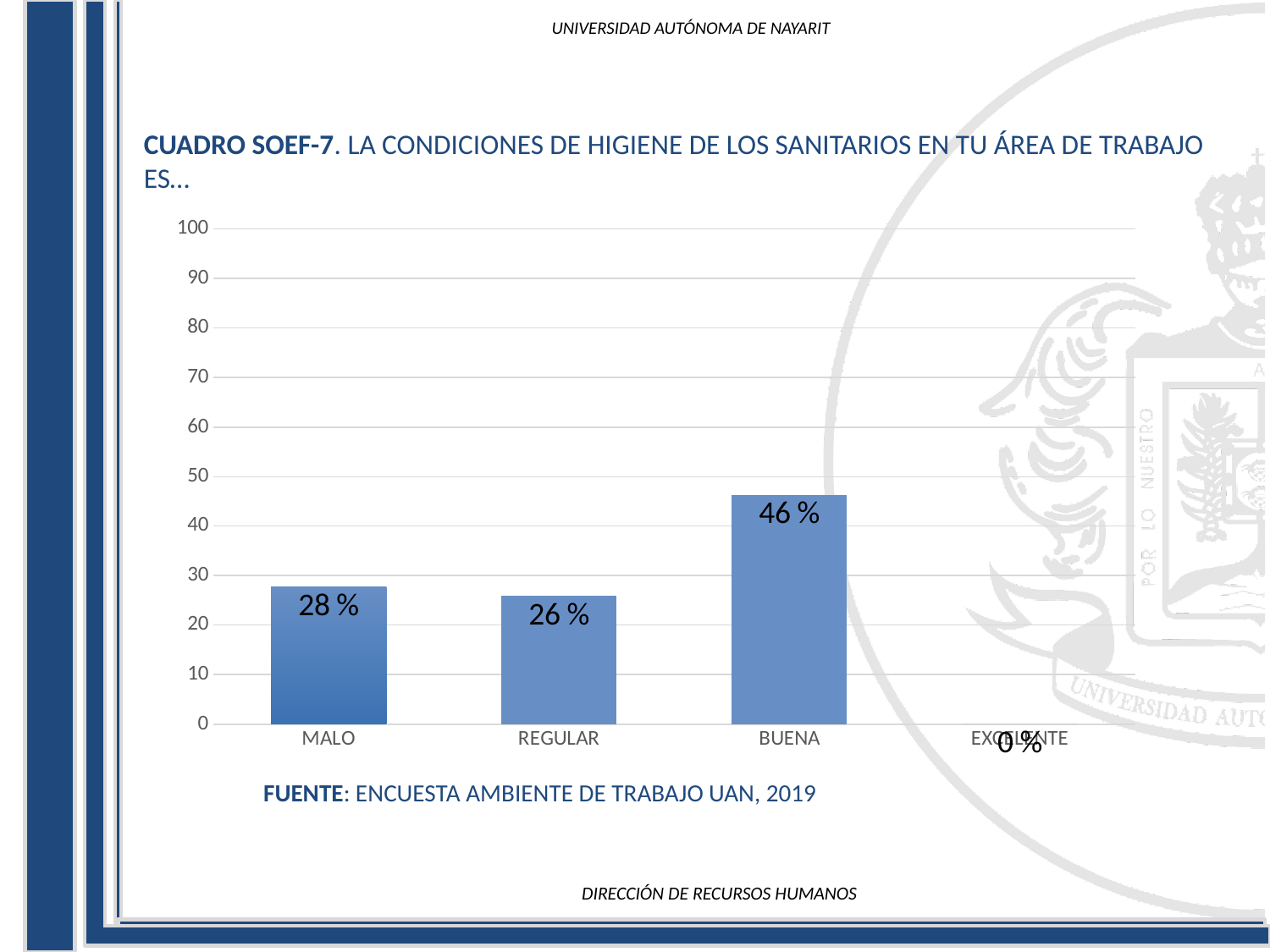
How many categories are shown on the x axis? 4 What is the value for REGULAR? 26 % What source is cited below the chart? ENCUESTA AMBIENTE DE TRABAJO UAN, 2019 What is the value for MALO? 28 % Which is larger, the value for MALO or the value for REGULAR? MALO Which category has the lowest value? EXCELENTE What kind of chart is shown on the slide? bar chart What is the value for BUENA? 46 % What is the value for EXCELENTE? 0 % What is the difference between the values for BUENA and MALO? 18 % Is the value for BUENA greater or less than 40? greater Which category has the highest value? BUENA